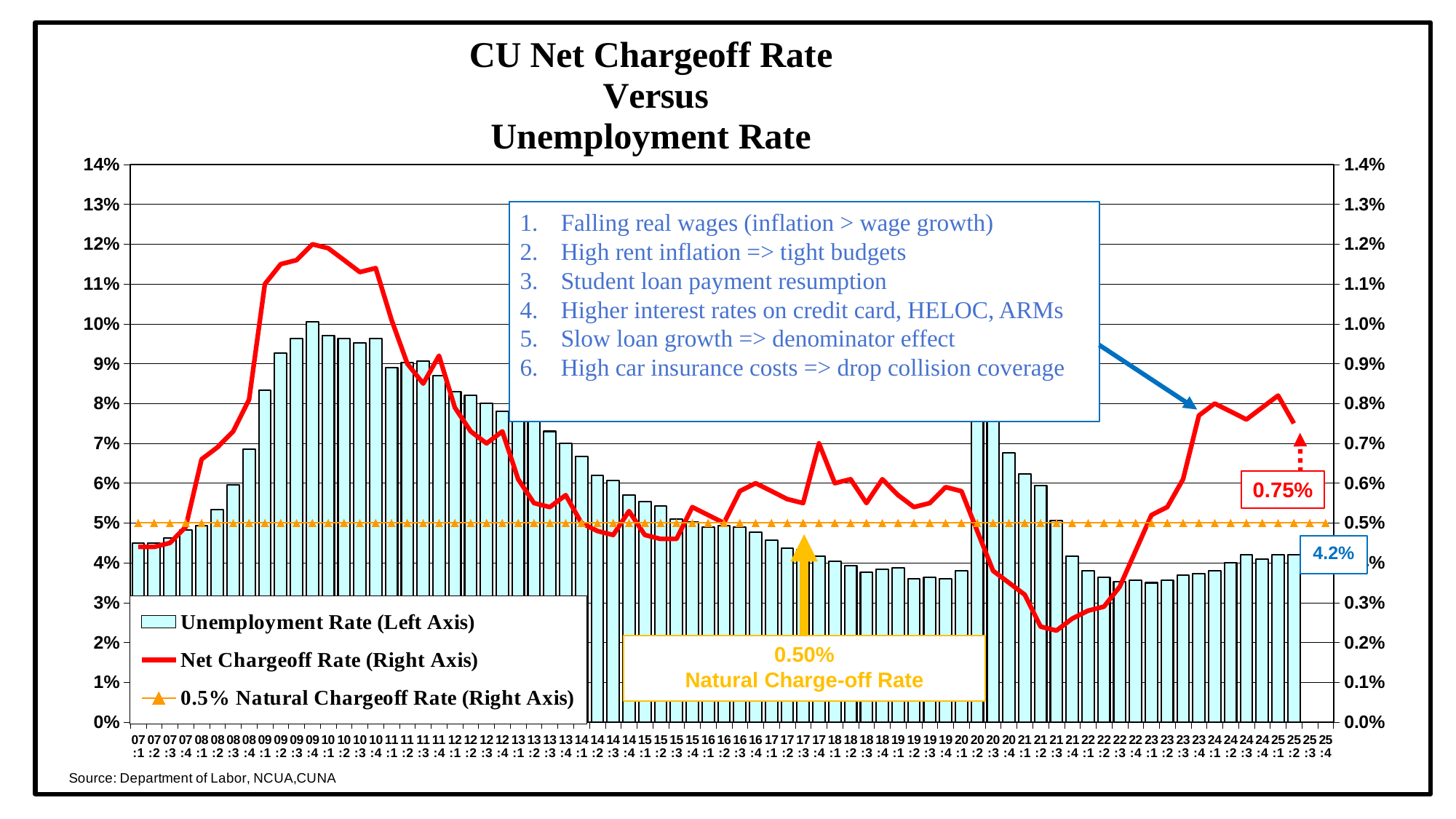
Which is larger, the net chargeoff rate in 09:4 or in 17:4? 09:4 What is the most recent net chargeoff rate labeled on the chart? 0.75% What is the most recent unemployment rate labeled on the chart? 4.2% Is the net chargeoff rate in 23:4 greater or less than 0.7%? greater Is the unemployment rate in 19:2 greater or less than 4%? less How many series does the legend list? 3 What value is the natural charge-off rate line set at? 0.50% Is the net chargeoff rate in 21:3 greater or less than 0.3%? less What is the title of the chart? CU Net Chargeoff Rate Versus Unemployment Rate What kind of chart is shown on the slide? A combined bar and line chart Does the unemployment rate rise or fall from 10:1 to 19:4? fall